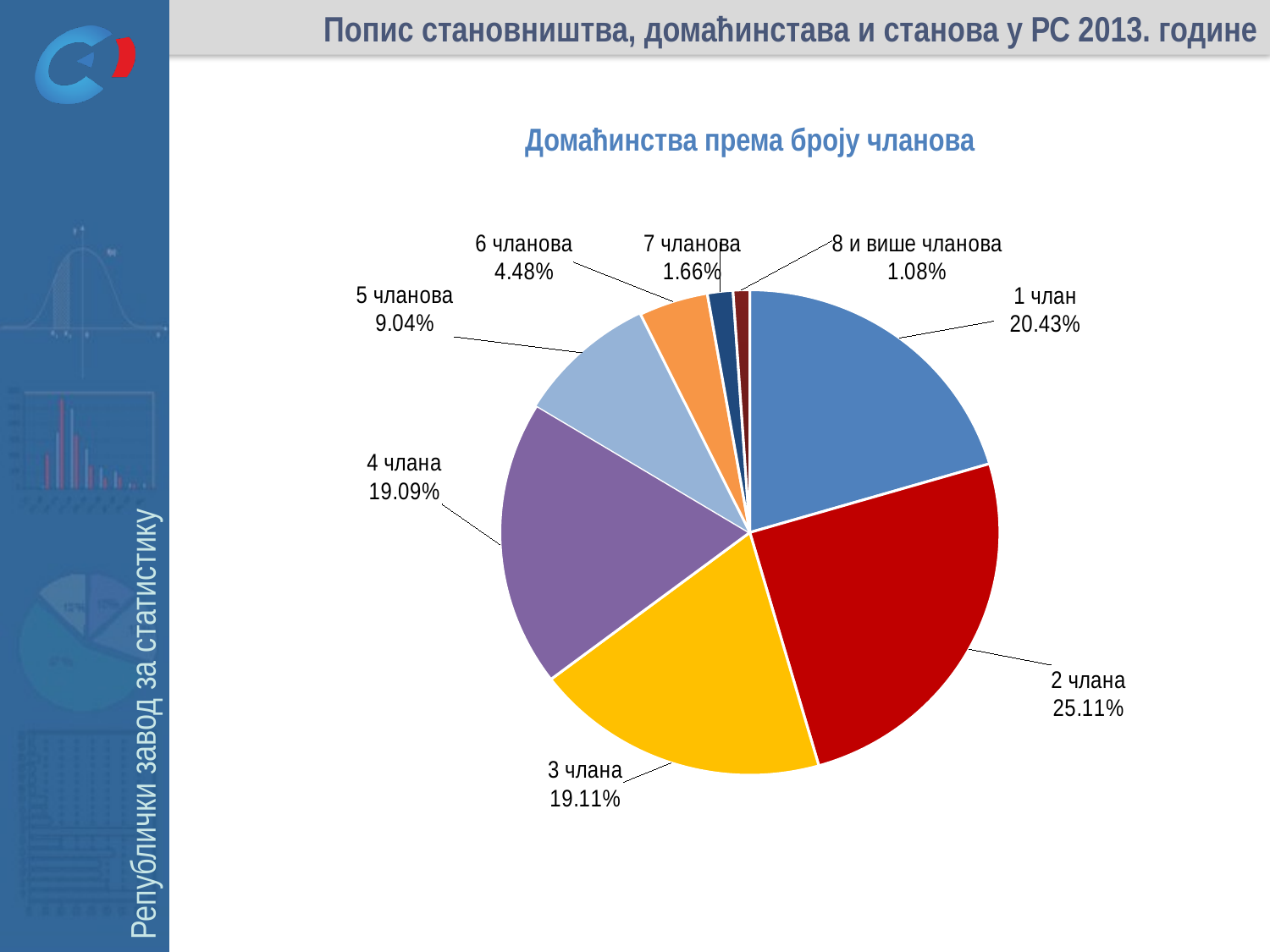
What share of households have 5 чланова? 9.04% What is the combined share of the 7 чланова and 8 и више чланова slices? 2.74% How many slices does the pie chart have? 8 What share of households have 2 члана? 25.11% What type of chart is shown on the slide? pie chart Which category has the smallest slice of the pie? 8 и више чланова What is the difference in percentage points between the 2 члана and 1 члан slices? 4.68 What share of households have 8 и више чланова? 1.08% Which is larger, the share for 5 чланова or the share for 6 чланова? 5 чланова Which category has the largest slice of the pie? 2 члана What share of households have 1 члан? 20.43% What is the title of the chart? Домаћинства према броју чланова